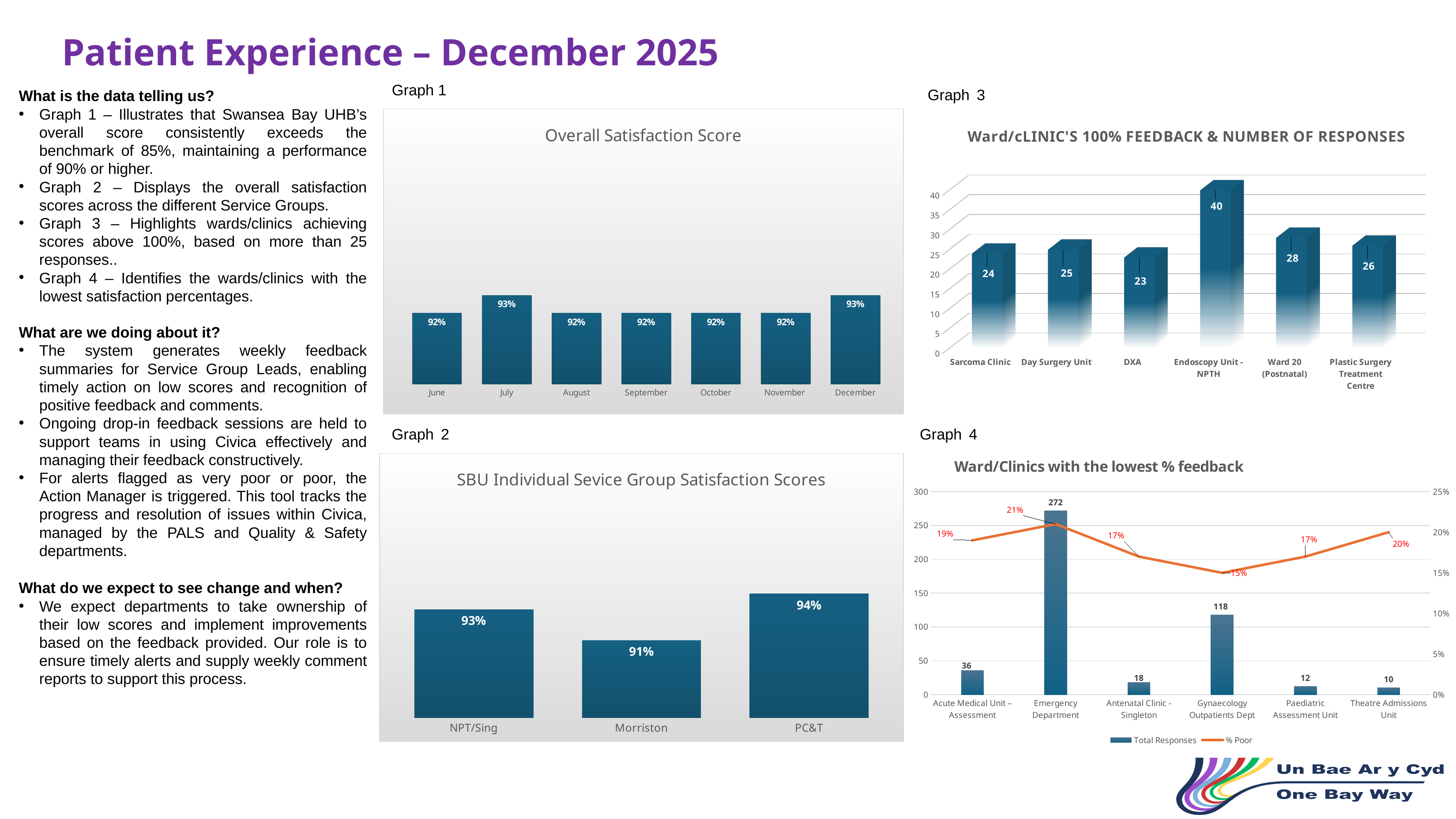
In the Overall Satisfaction Score chart (Graph 1), how many months are plotted? 7 In the Ward/Clinic's 100% Feedback & Number of Responses chart (Graph 3), what kind of chart is shown? Bar chart In the Ward/Clinics with the lowest % feedback chart (Graph 4), which has more Total Responses, Acute Medical Unit – Assessment or Antenatal Clinic - Singleton? Acute Medical Unit – Assessment In the SBU Individual Service Group Satisfaction Scores chart (Graph 2), which service group has the lowest score? Morriston In the Ward/Clinic's 100% Feedback & Number of Responses chart (Graph 3), which ward/clinic has the highest number of responses? Endoscopy Unit - NPTH In the Ward/Clinics with the lowest % feedback chart (Graph 4), what is the % Poor value for Gynaecology Outpatients Dept? 15% In the Ward/Clinic's 100% Feedback & Number of Responses chart (Graph 3), what is the value for DXA? 23 In the SBU Individual Service Group Satisfaction Scores chart (Graph 2), what is the difference between the PC&T and Morriston scores? 3% In the Ward/Clinics with the lowest % feedback chart (Graph 4), how many series does the legend list? 2 In the Overall Satisfaction Score chart (Graph 1), what is the value for July? 93% In the SBU Individual Service Group Satisfaction Scores chart (Graph 2), what is the value for PC&T? 94% In the Ward/Clinics with the lowest % feedback chart (Graph 4), what is the Total Responses value for Emergency Department? 272